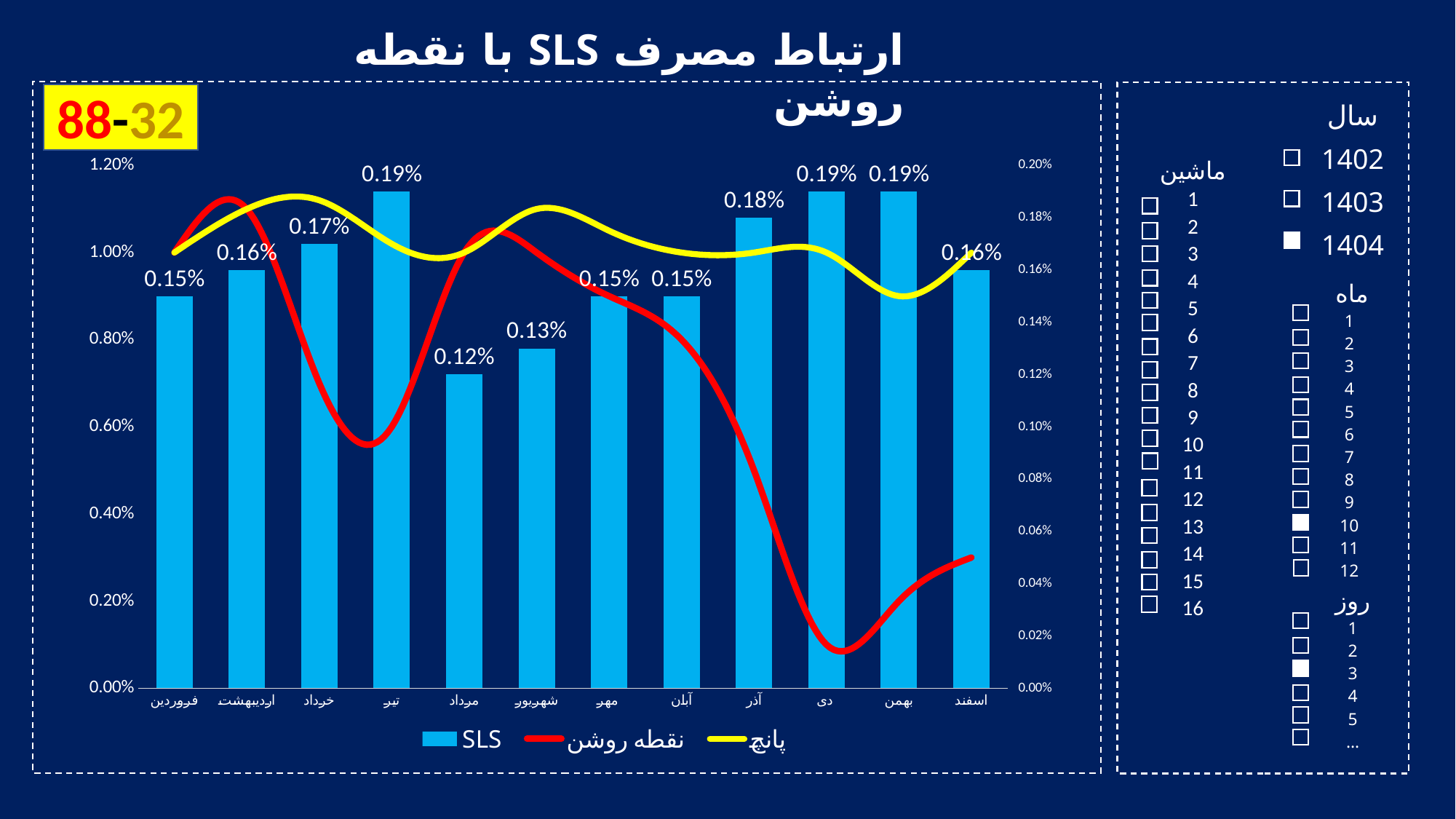
What is the SLS value for تیر? 0.19% How many series does the legend list? 3 What is the SLS value for مرداد? 0.12% Which month has the lowest SLS value? مرداد Which has a larger SLS value, خرداد or اردیبهشت? خرداد What is the SLS value for آذر? 0.18% What is the difference between the SLS values for تیر and مرداد? 0.07% How many months are shown on the x axis? 12 What kind of chart is this? Combined bar and line chart What is the highest SLS value shown on the bars? 0.19% What is the difference between the SLS values for آذر and شهریور? 0.05% Do the SLS bar values rise or fall from مرداد to بهمن? Rise